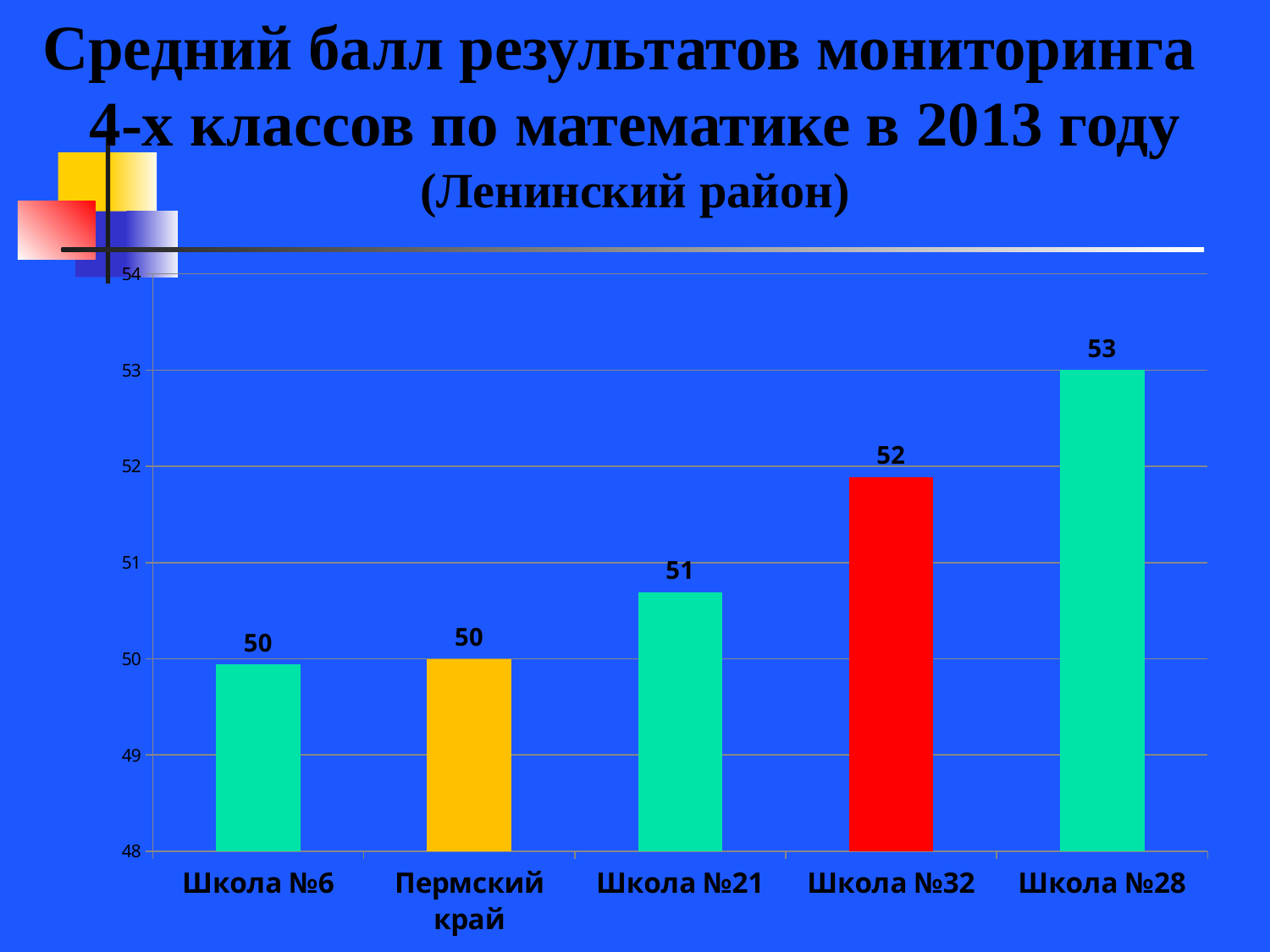
Do the values generally rise or fall from left to right along the x axis? rise What is the value shown for Школа №32? 52 What is the value shown for Пермский край? 50 How many categories are shown on the x axis? 5 Which is larger, the value for Школа №32 or the value for Школа №21? Школа №32 What is the value shown for Школа №28? 53 Is the value for Школа №21 greater or less than 50? greater What is the difference between the values for Школа №28 and Школа №6? 3 What is the value shown for Школа №21? 51 Which category has the highest value? Школа №28 What kind of chart is shown on the slide? bar chart What colour is the bar for Школа №32? red